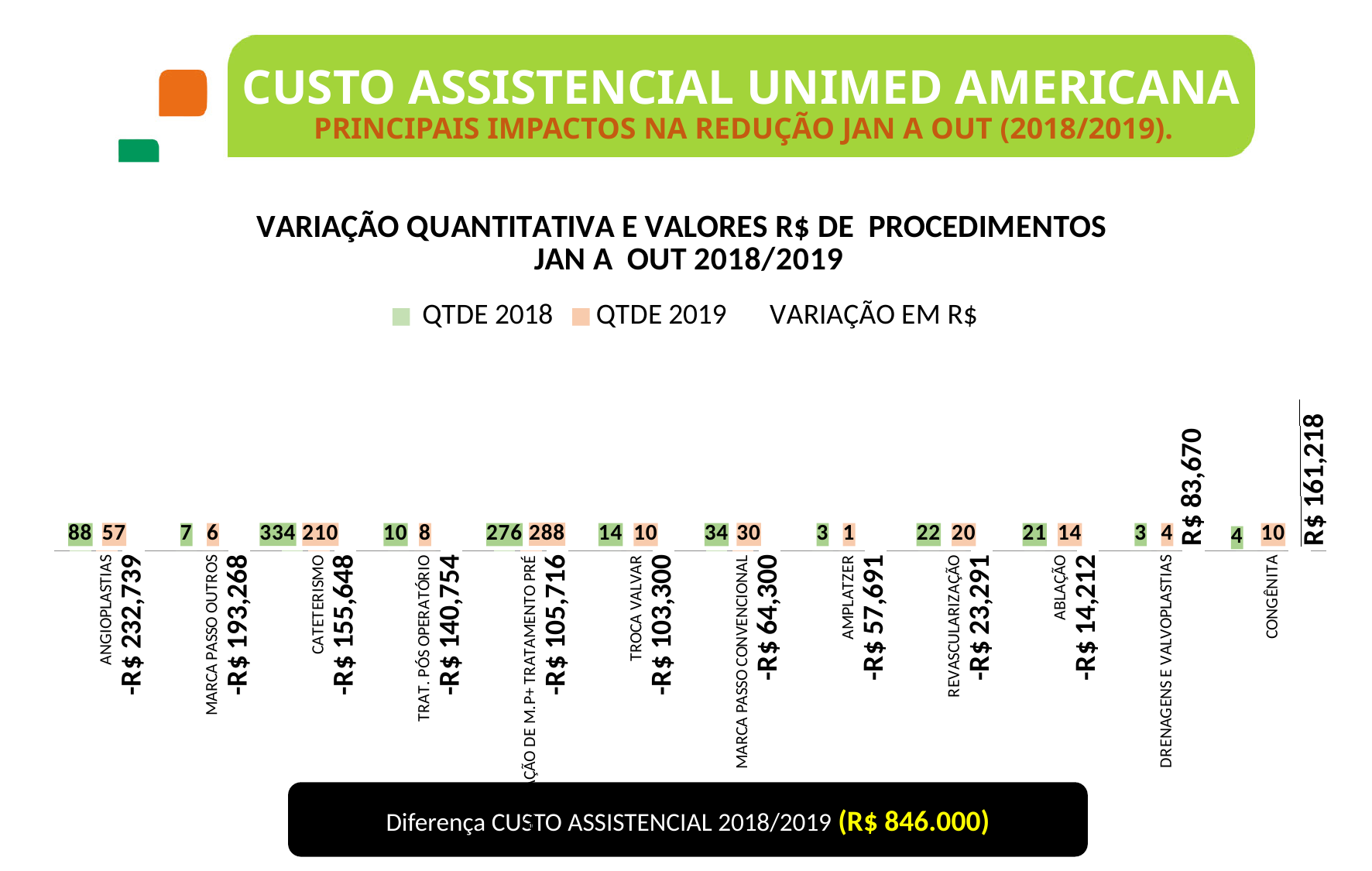
Which category has the highest QTDE 2018 value? CATETERISMO What kind of chart is used to show the QTDE 2018 and QTDE 2019 values? Bar chart What is the QTDE 2019 value for ANGIOPLASTIAS? 57 What is the QTDE 2018 value for CATETERISMO? 334 How many categories are shown on the x axis of the chart? 12 Which is larger for ABLAÇÃO, the QTDE 2018 value or the QTDE 2019 value? QTDE 2018 What is the difference between the QTDE 2018 and QTDE 2019 values for CATETERISMO? 124 How many series does the chart legend list? 3 Which category has the lowest QTDE 2019 value? AMPLATZER What is the VARIAÇÃO EM R$ value for CONGÊNITA? R$ 161,218 What is the VARIAÇÃO EM R$ value for TROCA VALVAR? -R$ 103,300 Which colour represents QTDE 2019 in the legend? Orange